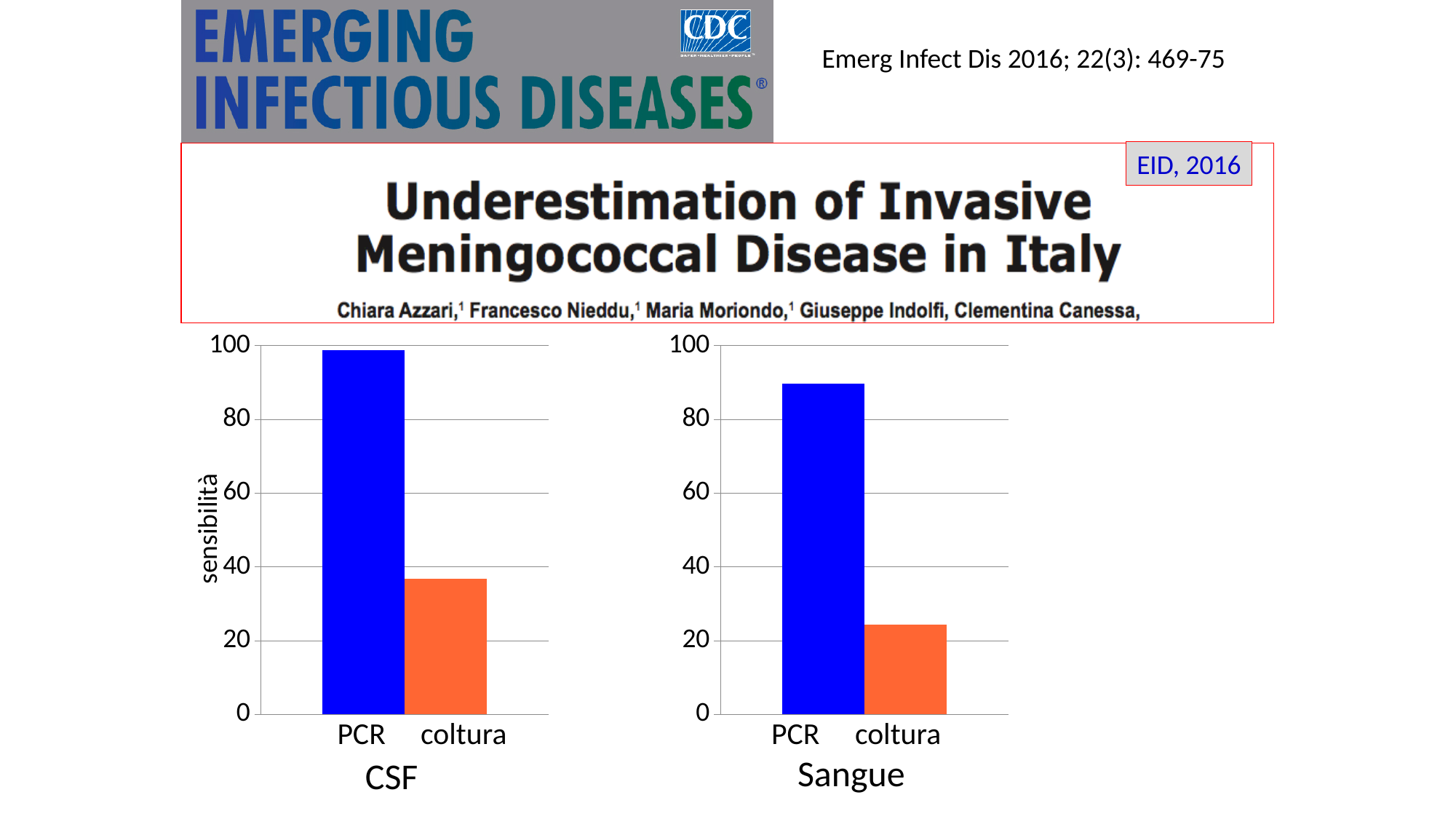
In the CSF chart, is the value for coltura greater or less than 40? less In the Sangue chart, how many bars are there? 2 In the Sangue chart, which category has the lowest value? coltura In the Sangue chart, what colour is the coltura bar? orange In the CSF chart, how many categories are plotted? 2 In the Sangue chart, which is larger, PCR or coltura? PCR In the CSF chart, is the value for PCR greater or less than 80? greater In the Sangue chart, is the value for PCR greater or less than 80? greater In the CSF chart, which category has the highest value? PCR In the CSF chart, what kind of chart is shown? bar chart In the CSF chart, what is the label on the vertical axis? sensibilità